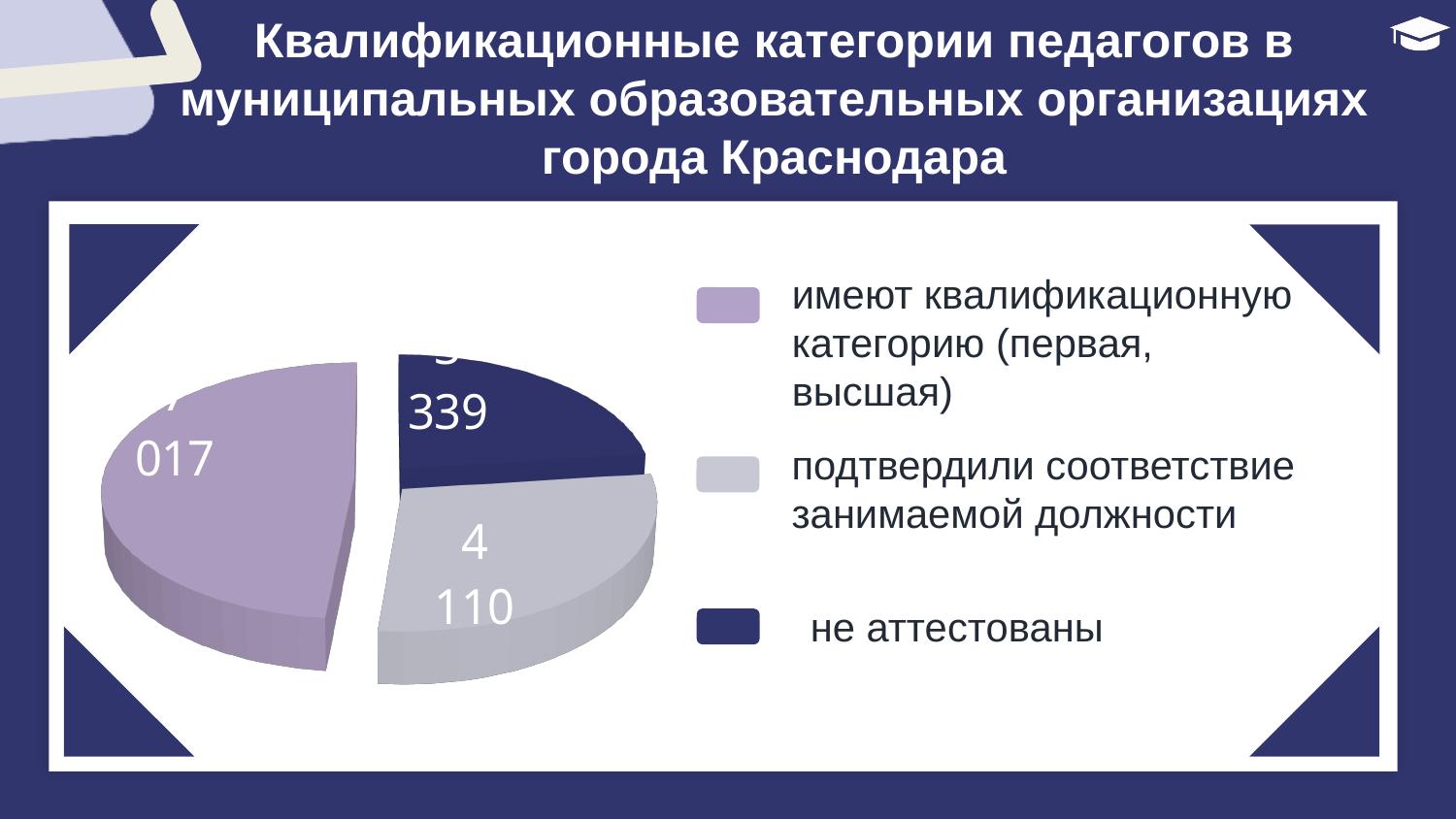
How many entries does the legend list? 3 What is the value shown for the slice 'подтвердили соответствие занимаемой должности'? 4 110 Which slice is larger: 'имеют квалификационную категорию (первая, высшая)' or 'подтвердили соответствие занимаемой должности'? имеют квалификационную категорию (первая, высшая) What kind of chart is shown on the slide? pie chart How many slices does the pie chart have? 3 What colour is the slice for 'не аттестованы'? dark navy blue Which category has the largest slice of the pie? имеют квалификационную категорию (первая, высшая) Which category has the smallest slice of the pie? не аттестованы What is the title of the slide containing the chart? Квалификационные категории педагогов в муниципальных образовательных организациях города Краснодара Which slice is larger: 'подтвердили соответствие занимаемой должности' or 'не аттестованы'? подтвердили соответствие занимаемой должности